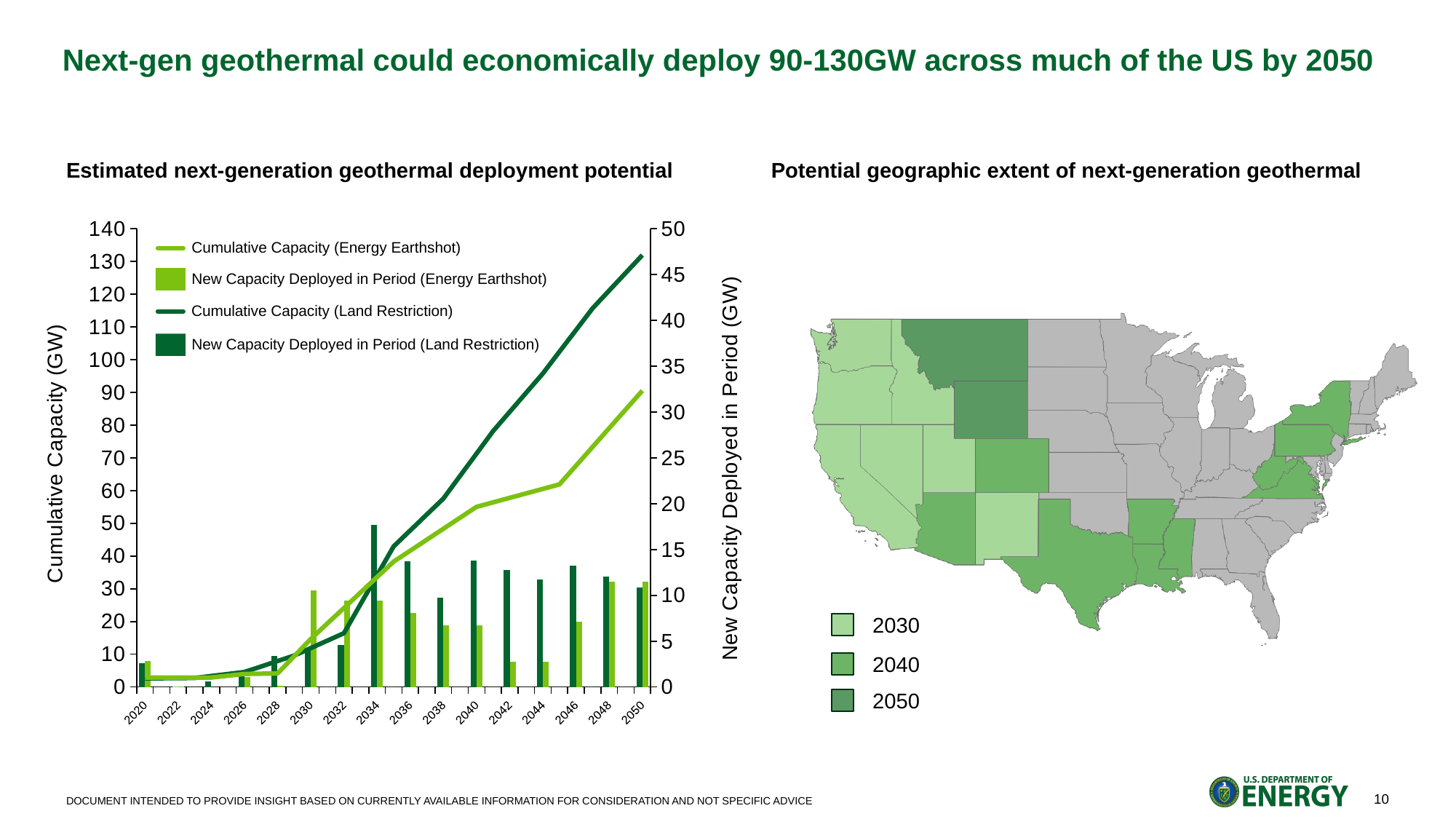
In the 'Estimated next-generation geothermal deployment potential' chart, which year has the tallest New Capacity Deployed in Period (Land Restriction) bar? 2034 How many series does the legend of the 'Estimated next-generation geothermal deployment potential' chart list? 4 What is the label of the right-hand y axis of the 'Estimated next-generation geothermal deployment potential' chart? New Capacity Deployed in Period (GW) In the 'Estimated next-generation geothermal deployment potential' chart, does Cumulative Capacity (Land Restriction) rise or fall from 2020 to 2050? Rise What kind of chart is 'Estimated next-generation geothermal deployment potential'? A combination bar and line chart How many years are labelled on the x axis of the 'Estimated next-generation geothermal deployment potential' chart? 16 In the 'Estimated next-generation geothermal deployment potential' chart, which is higher in 2050: Cumulative Capacity (Land Restriction) or Cumulative Capacity (Energy Earthshot)? Cumulative Capacity (Land Restriction) In the 'Estimated next-generation geothermal deployment potential' chart, is Cumulative Capacity (Energy Earthshot) in 2050 greater or less than 80 GW? greater In the 'Estimated next-generation geothermal deployment potential' chart, is Cumulative Capacity (Energy Earthshot) in 2040 greater or less than 50 GW? greater In the 'Estimated next-generation geothermal deployment potential' chart, is Cumulative Capacity (Land Restriction) in 2050 greater or less than 120 GW? greater Which three years are listed in the legend of the 'Potential geographic extent of next-generation geothermal' map? 2030, 2040, 2050